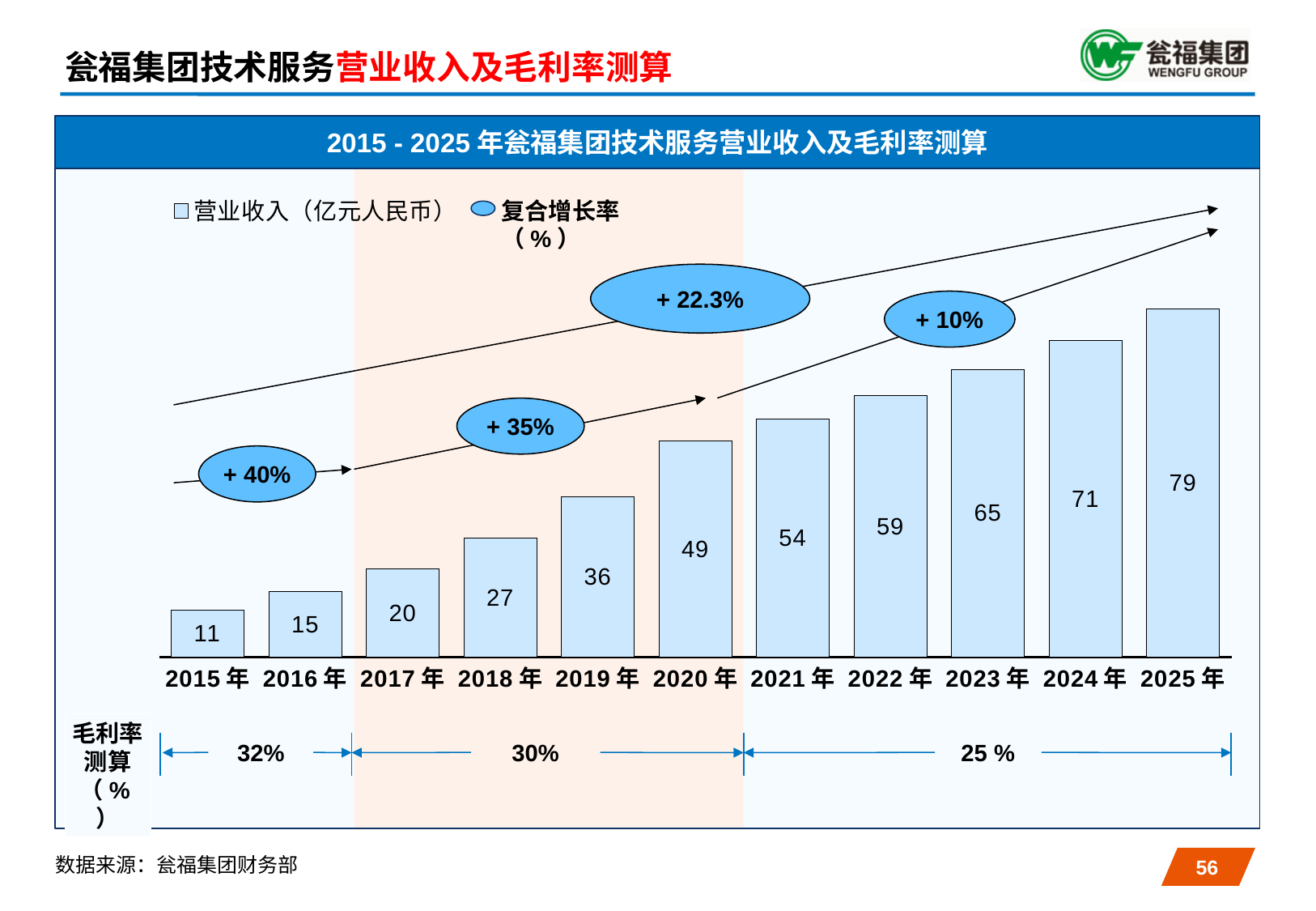
What is the difference in 营业收入 between 2020 年 and 2019 年? 13 How many years are shown on the x axis? 11 What 复合增长率 is shown for the 2017–2020 period? + 35% Which is larger, the 营业收入 for 2018 年 or for 2021 年? 2021 年 Which year has the highest 营业收入? 2025 年 What is the 营业收入 value for 2019 年? 36 What is the difference in 营业收入 between 2025 年 and 2015 年? 68 What 毛利率测算 is shown for the 2021–2025 period? 25 % Which year has the lowest 营业收入? 2015 年 What is the 营业收入 value for 2023 年? 65 Do the 营业收入 values rise or fall from 2015 年 to 2025 年? rise What kind of chart is this? bar chart